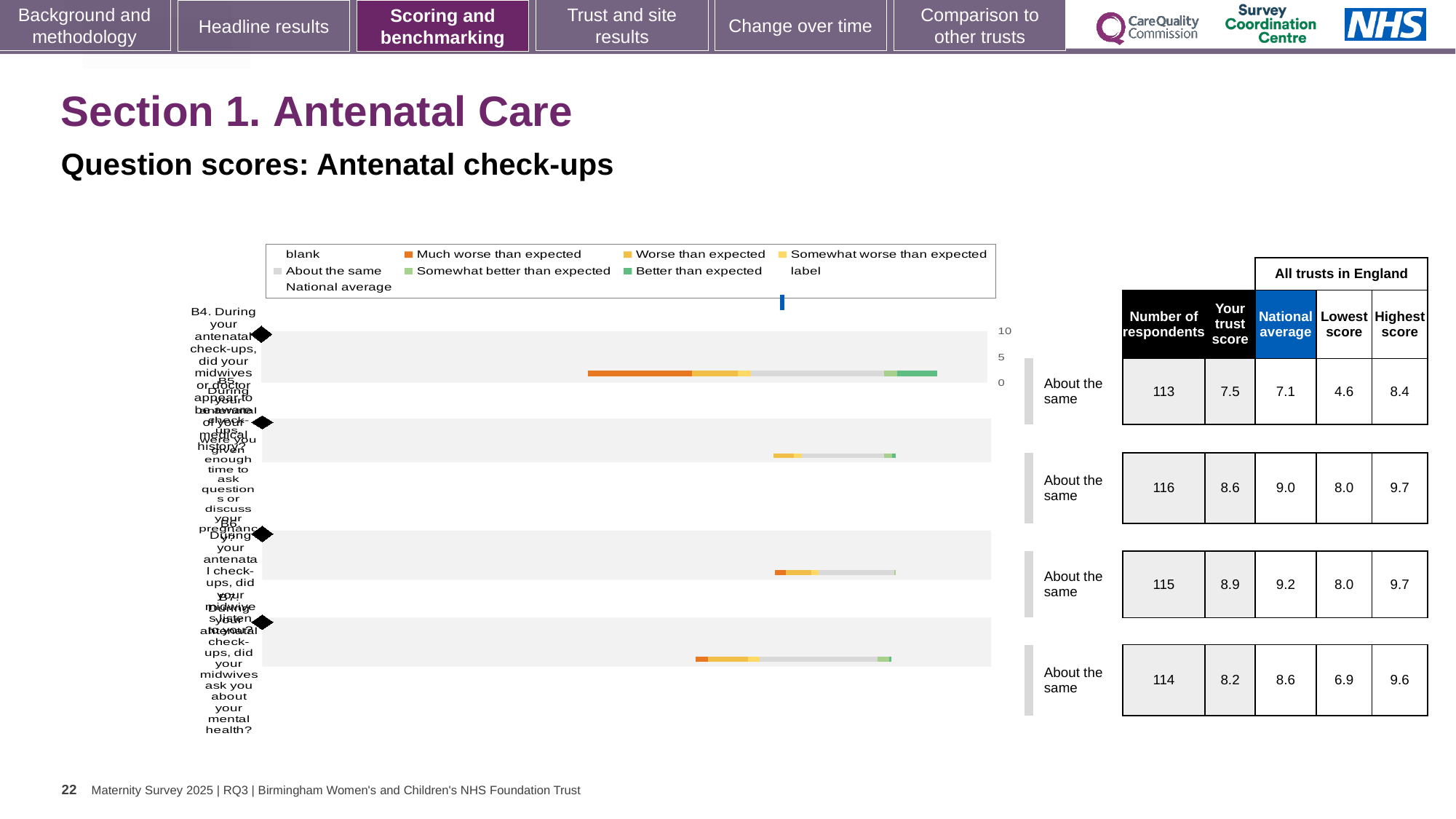
What kind of chart is shown on the slide? bar chart In the table next to the chart, what is the number of respondents for the first row (B4)? 113 How many question rows (bars) are plotted in the chart? 4 Which legend entry is shown in orange in the chart? Much worse than expected In the table next to the chart, what is the national average for the fourth row (B7, mental health)? 8.6 In the table next to the chart, is the trust score for the second row larger or smaller than its national average? smaller What is the highest tick value shown on the chart's axis? 10 In the table next to the chart, which row has the highest 'Your trust score'? third row (8.9) In the table next to the chart, what is the difference between the highest score and the lowest score for the first row (B4)? 3.8 In the table next to the chart, which row has the lowest 'Your trust score'? first row (B4, 7.5) In the table next to the chart, what is the lowest score for the fourth row (B7, mental health)? 6.9 In the table next to the chart, what is the trust score for the first row (B4)? 7.5